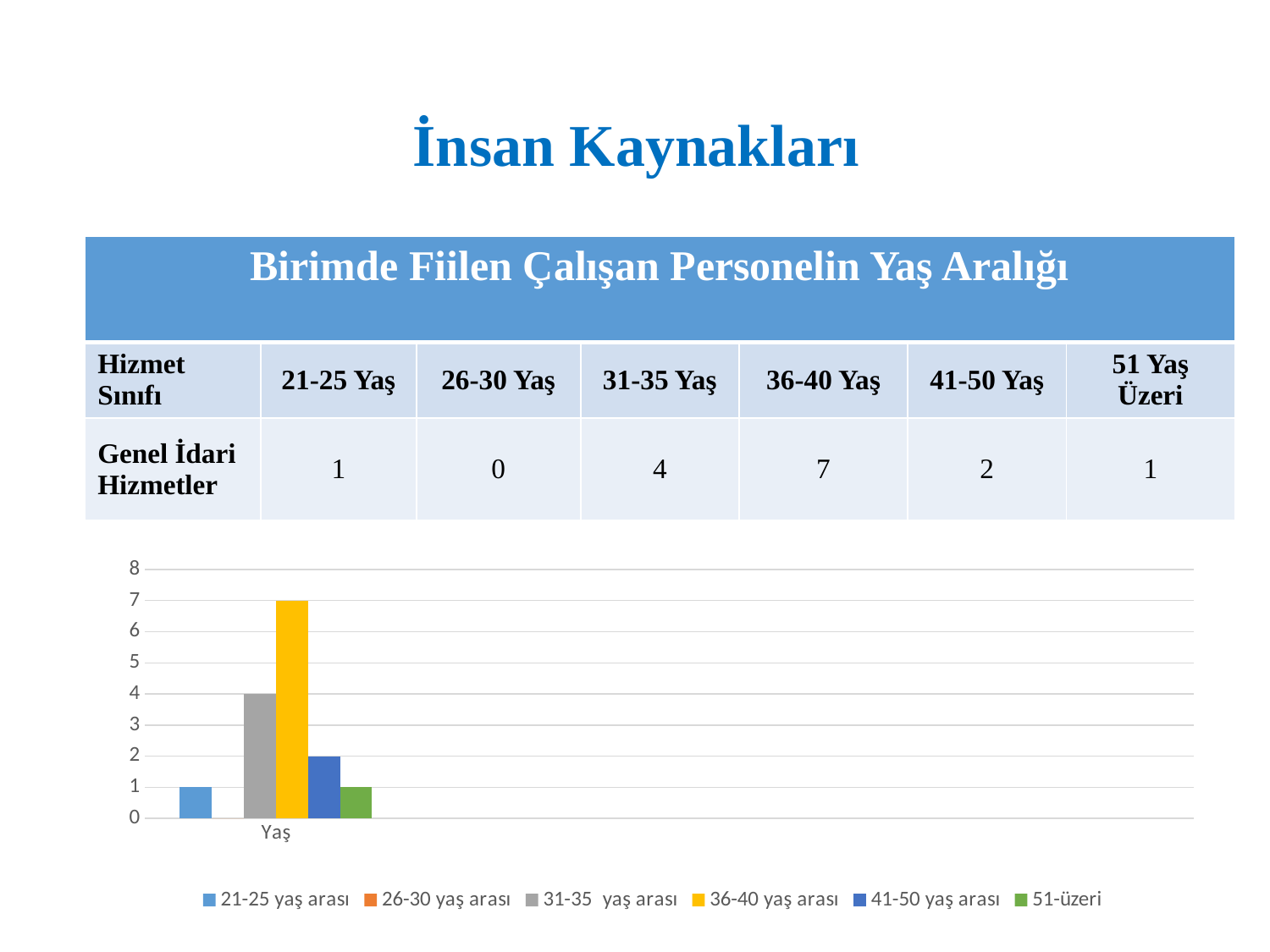
Which series has the highest value in the chart? 36-40 yaş arası What is the value for the 41-50 yaş arası series in the chart? 2 Is the value for 36-40 yaş arası greater or less than 5? greater What is the value for the 36-40 yaş arası series in the chart? 7 What is the value for the 31-35 yaş arası series in the chart? 4 What is the category label shown on the x axis of the chart? Yaş What kind of chart is shown on the slide? bar chart Which is larger in the chart, the 41-50 yaş arası value or the 51-üzeri value? 41-50 yaş arası How many series does the chart legend list? 6 Which series has the lowest value in the chart? 26-30 yaş arası What is the difference between the 36-40 yaş arası value and the 31-35 yaş arası value? 3 What is the value for the 21-25 yaş arası series in the chart? 1